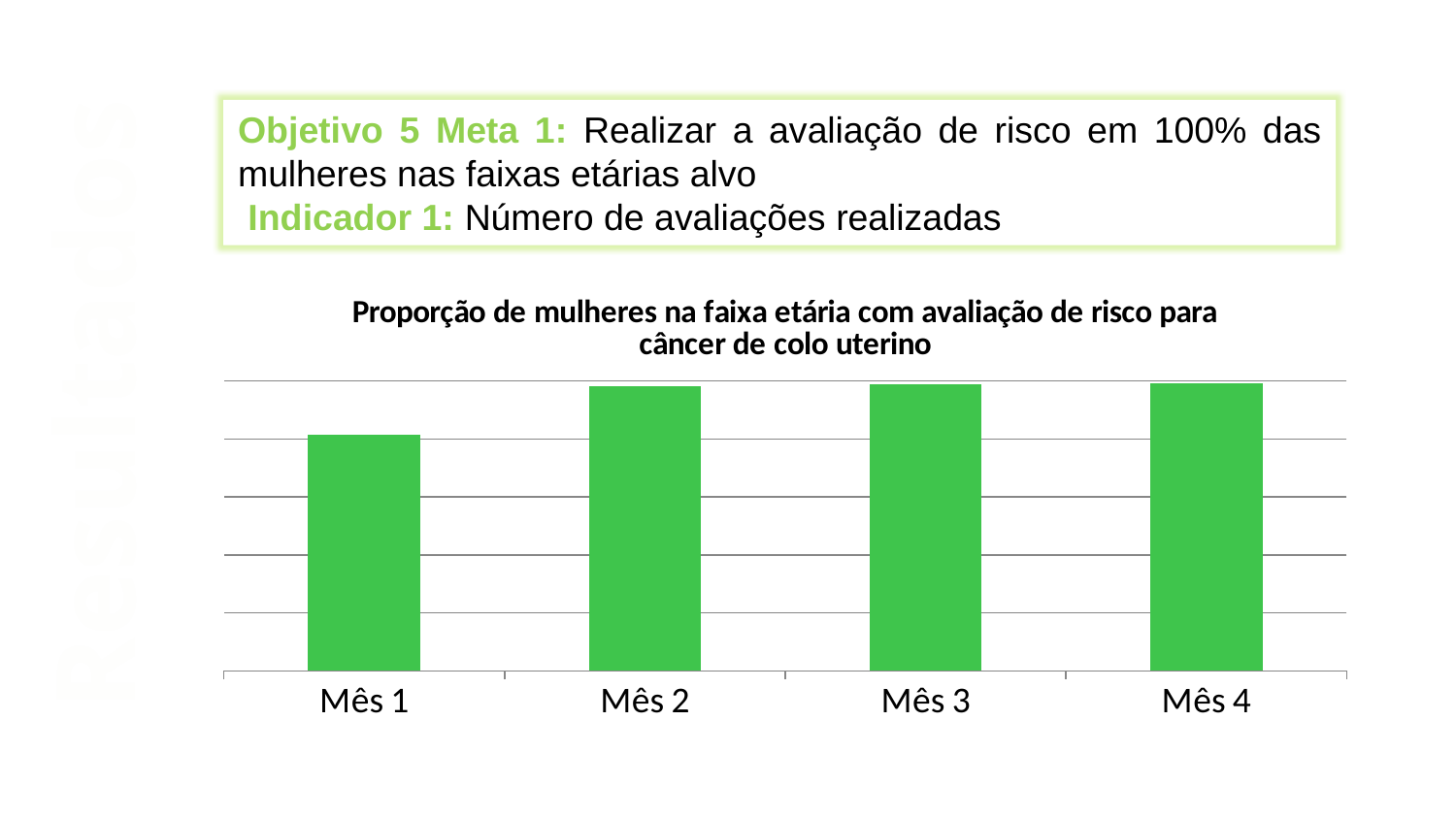
Which is larger, the value for Mês 1 or the value for Mês 2? Mês 2 What is the title of the chart? Proporção de mulheres na faixa etária com avaliação de risco para câncer de colo uterino What kind of chart is shown on the slide? bar chart What is the label of the first category on the x axis? Mês 1 Does the value rise or fall from Mês 1 to Mês 2? rise Which is larger, the value for Mês 1 or the value for Mês 4? Mês 4 What colour are the bars in the chart? green Which month has the lowest bar in the chart? Mês 1 How many categories (months) are shown on the x axis of the chart? 4